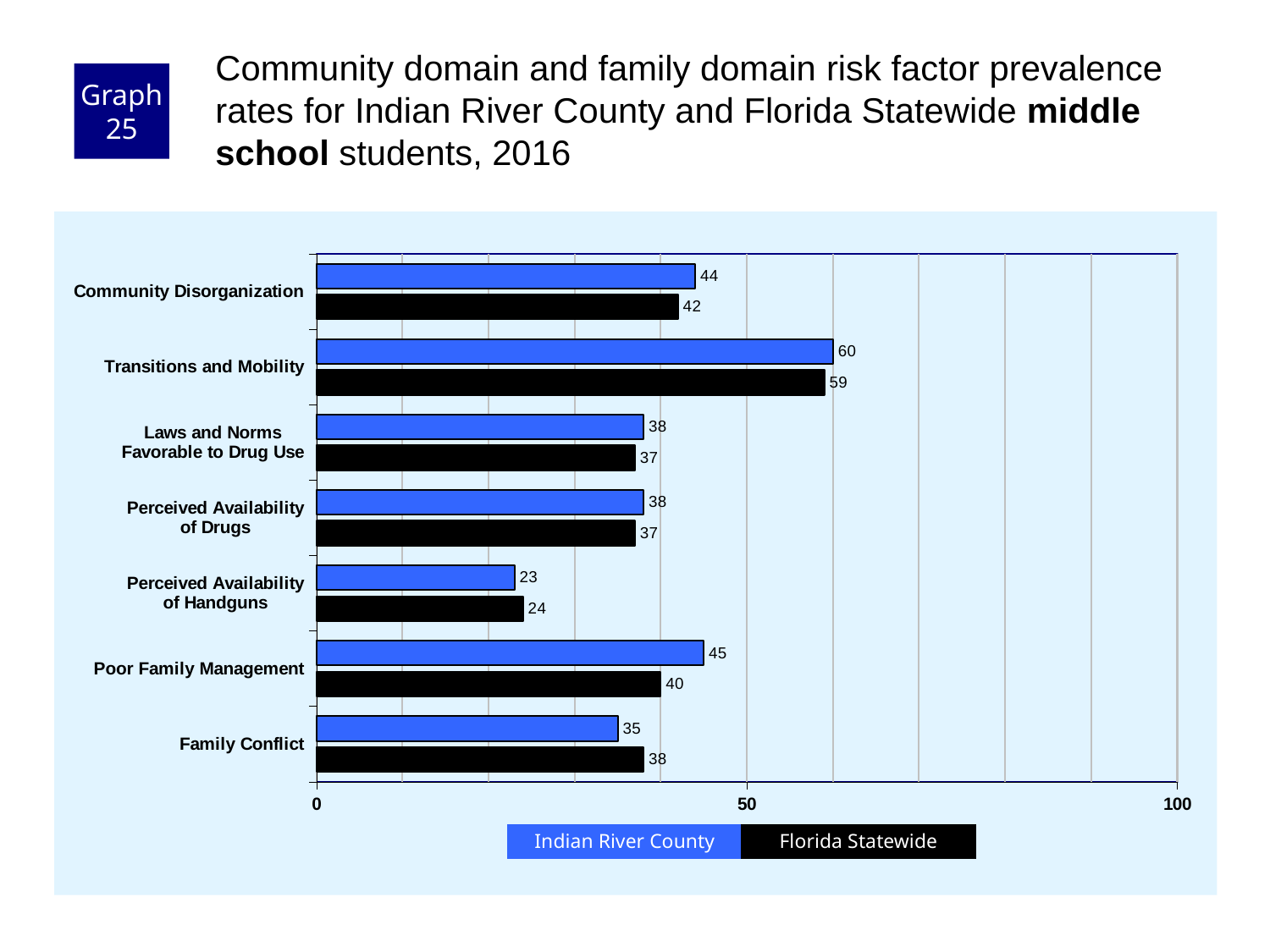
How many series does the legend list? 2 What is the difference between the Indian River County and Florida Statewide values for Poor Family Management? 5 Is the Indian River County value for Community Disorganization greater or less than 50? less What is the Indian River County value for Transitions and Mobility? 60 Which risk factor has the highest Indian River County value? Transitions and Mobility For Family Conflict, which is larger: the Indian River County value or the Florida Statewide value? Florida Statewide How many risk factor categories are shown on the chart? 7 Which colour represents Florida Statewide in the chart? black What is the Florida Statewide value for Poor Family Management? 40 What is the Florida Statewide value for Family Conflict? 38 Which risk factor has the lowest Florida Statewide value? Perceived Availability of Handguns What kind of chart is shown on the slide? bar chart